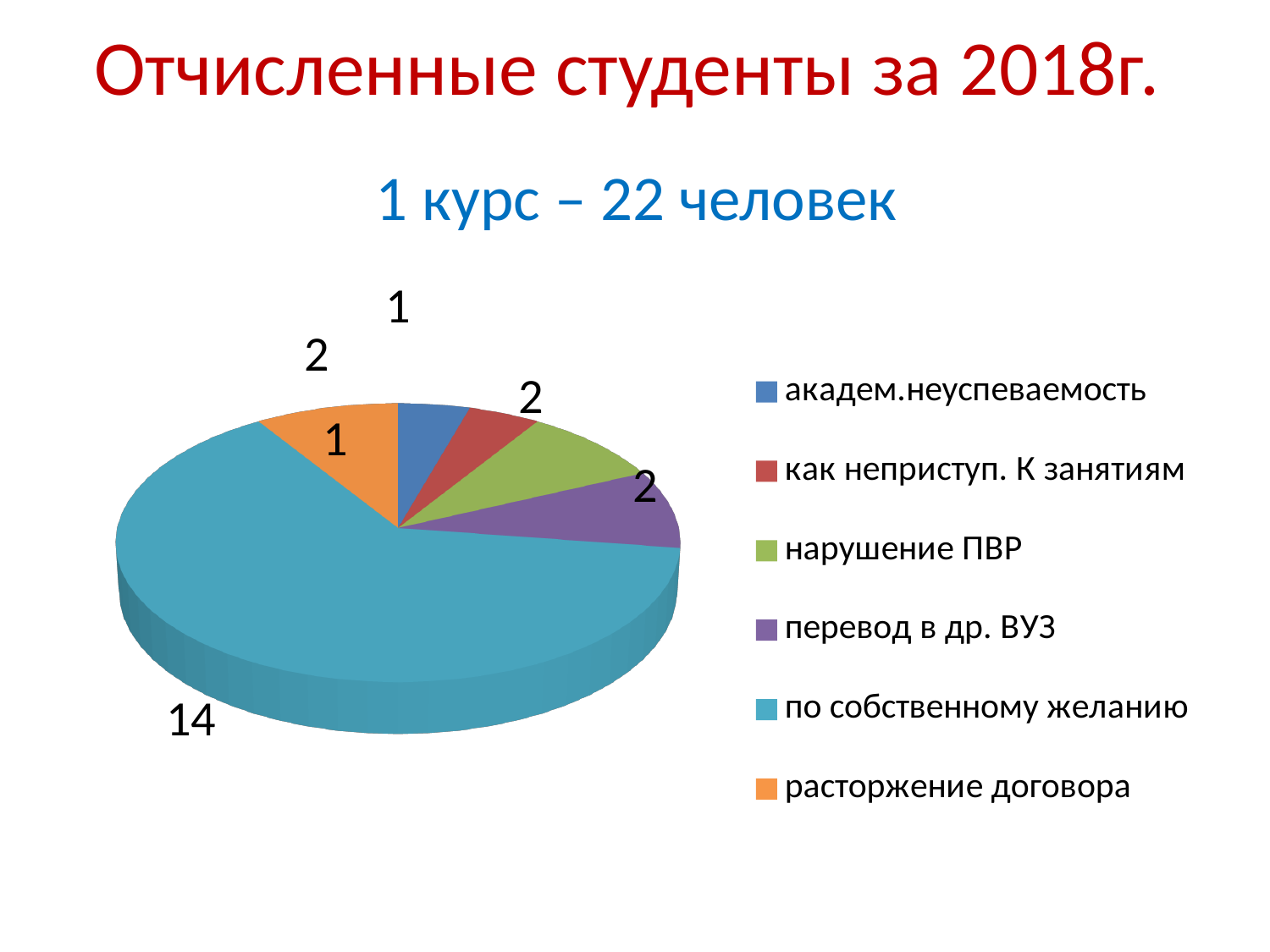
What is the value for "перевод в др. ВУЗ"? 2 How many slices does the pie chart have? 6 Which category has the largest slice of the pie? по собственному желанию What is the value for "по собственному желанию"? 14 How many entries does the legend list? 6 What colour is the slice for "по собственному желанию"? teal (light blue) What is the value for "как неприступ. К занятиям"? 1 What is the value for "нарушение ПВР"? 2 What is the title of the slide above the chart? Отчисленные студенты за 2018г. What kind of chart is shown on the slide? pie chart Which is larger, the value for "по собственному желанию" or the value for "расторжение договора"? по собственному желанию What is the difference between the value for "по собственному желанию" and the value for "перевод в др. ВУЗ"? 12